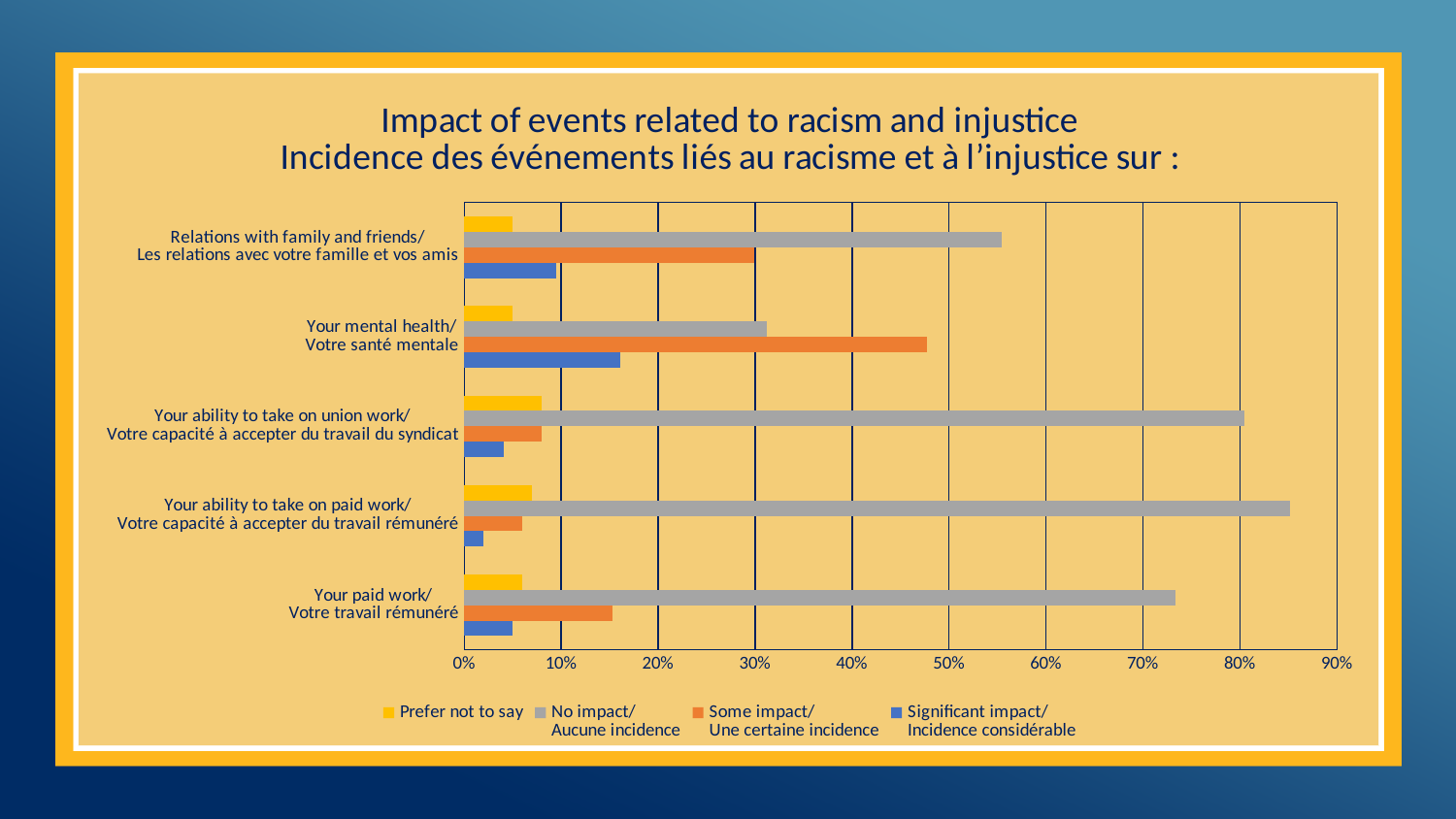
How many series does the legend list? 4 Which category has the highest value for the 'Significant impact' series? Your mental health How many categories are plotted on the y axis? 5 Is the 'No impact' value for 'Your mental health' greater or less than 40%? less Is the 'No impact' value for 'Relations with family and friends' greater or less than 50%? greater Is the 'Some impact' value for 'Your mental health' greater or less than 40%? greater What kind of chart is shown on the slide? Bar chart Which category has the highest value for the 'No impact' series? Your ability to take on paid work Which category has the highest value for the 'Some impact' series? Your mental health Which category has the lowest value for the 'Significant impact' series? Your ability to take on paid work What colour represents the 'Significant impact' series in the legend? Blue Which is larger: the 'Some impact' value for 'Relations with family and friends' or the 'Some impact' value for 'Your paid work'? Relations with family and friends